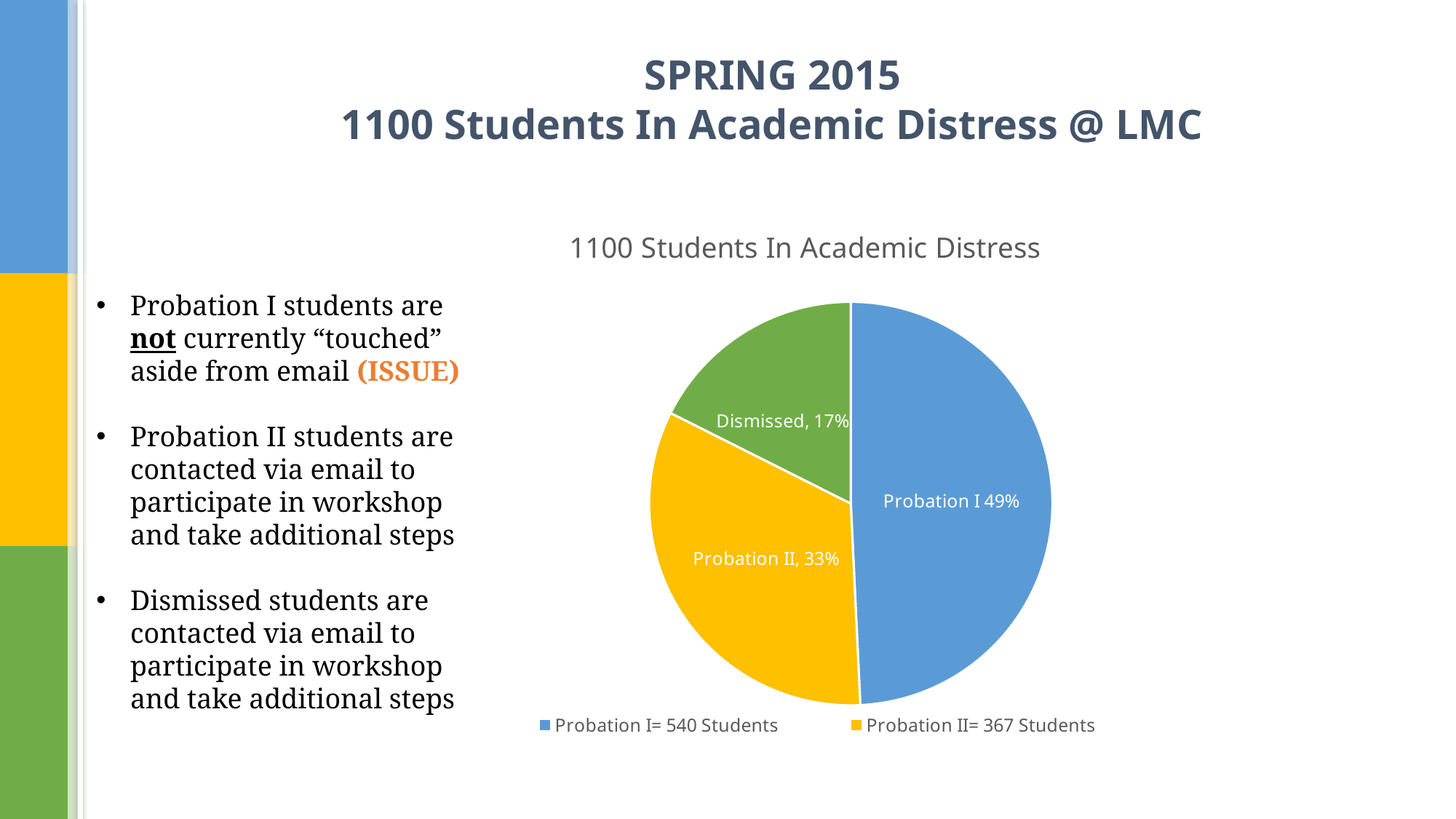
How many slices does the pie chart have? 3 What share of the pie does Probation I represent? 49% What type of chart is shown on the slide? pie chart Which slice of the pie is the largest? Probation I What is the difference in percentage points between the Probation I and Probation II slices? 16 How many entries does the chart's legend list? 2 Which slice of the pie is the smallest? Dismissed According to the legend, how many students are in Probation II? 367 Students What is the chart's title? 1100 Students In Academic Distress What share of the pie does Probation II represent? 33% What share of the pie does Dismissed represent? 17% Which is larger, the Probation II slice or the Dismissed slice? Probation II